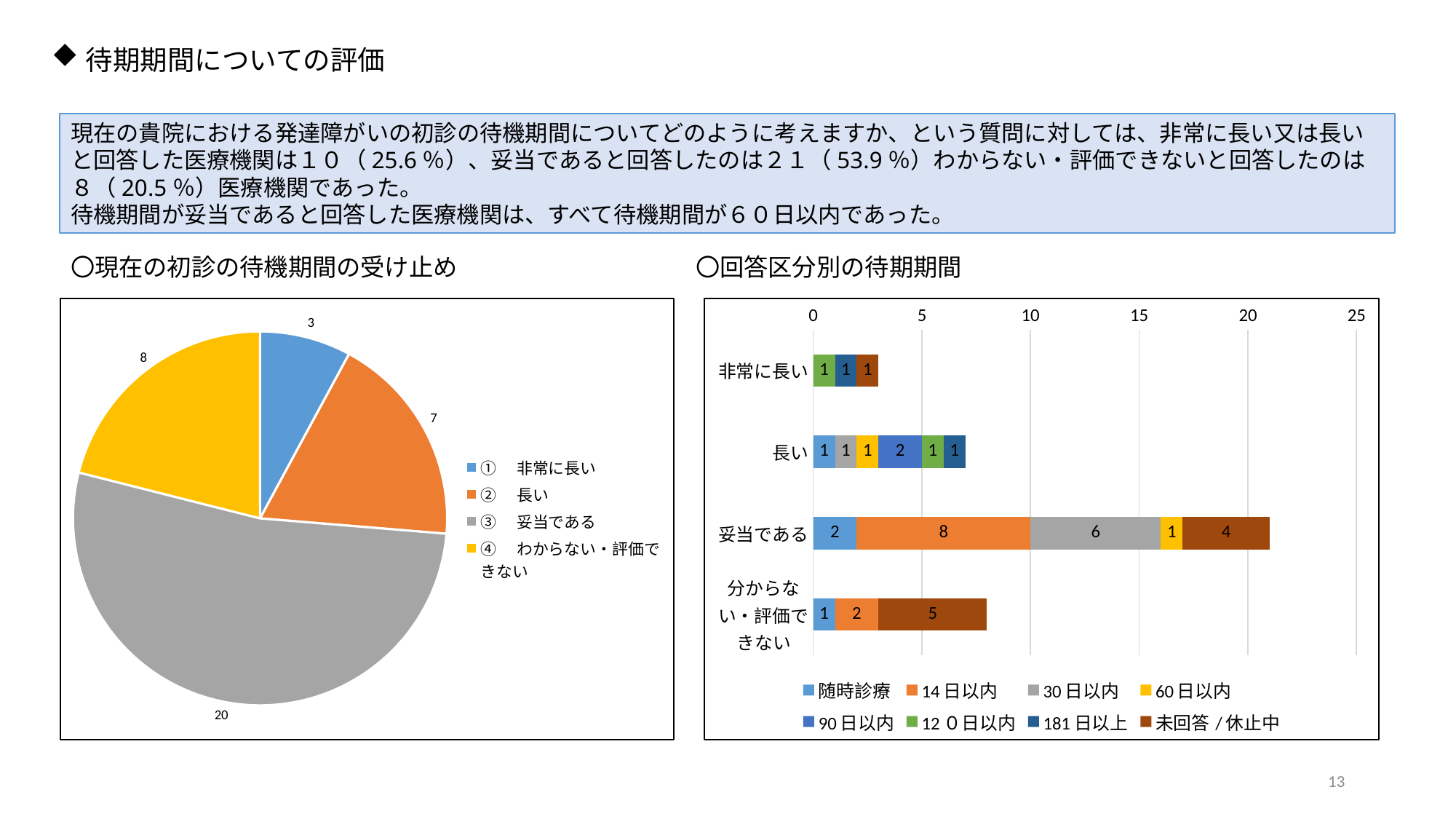
In the pie chart 現在の初診の待機期間の受け止め, what is the difference between the values for ④ わからない・評価できない and ② 長い? 1 In the bar chart 回答区分別の待期期間, how many series does the legend list? 8 In the bar chart 回答区分別の待期期間, what is the total of the stacked bar for 妥当である? 21 In the bar chart 回答区分別の待期期間, what is the total of the stacked bar for 長い? 7 In the pie chart 現在の初診の待機期間の受け止め, which category has the smallest slice? ① 非常に長い In the bar chart 回答区分別の待期期間, what is the value of the 未回答/休止中 segment for 分からない・評価できない? 5 In the pie chart 現在の初診の待機期間の受け止め, which category has the largest slice? ③ 妥当である In the pie chart 現在の初診の待機期間の受け止め, how many categories are shown? 4 In the pie chart 現在の初診の待機期間の受け止め, what value is shown for ① 非常に長い? 3 In the pie chart 現在の初診の待機期間の受け止め, what value is shown for ③ 妥当である? 20 In the bar chart 回答区分別の待期期間, what is the value of the 14日以内 segment for 妥当である? 8 What type of chart is 回答区分別の待期期間? Stacked bar chart